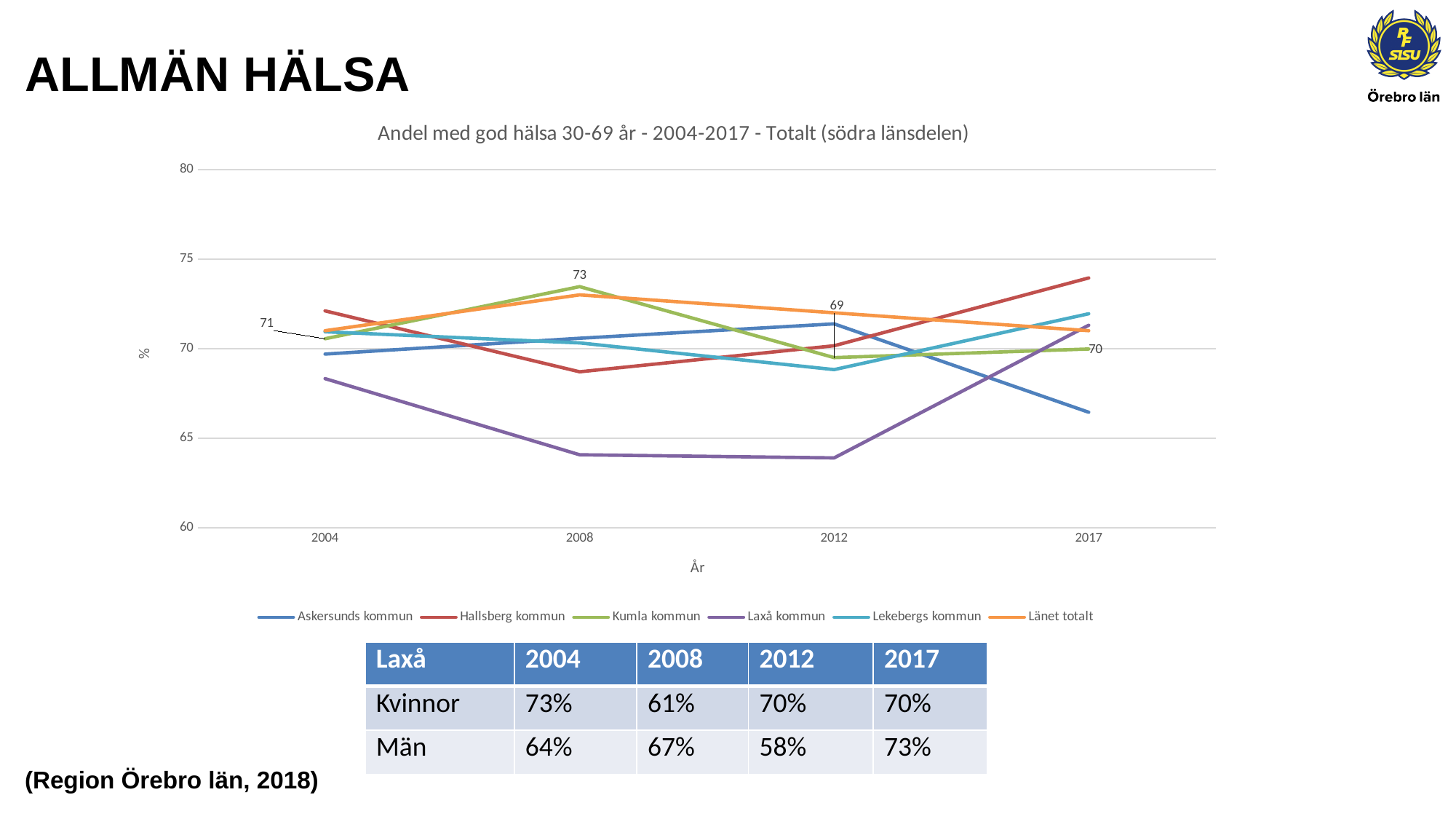
How many years are plotted along the x axis of the chart? 4 Does the Laxå kommun line rise or fall between 2012 and 2017? rise What is the title of the chart? Andel med god hälsa 30-69 år - 2004-2017 - Totalt (södra länsdelen) Which series has the highest value in 2017? Hallsberg kommun What is the label on the x axis of the chart? År Is the value for Laxå kommun in 2012 greater or less than 65? less How many series does the chart legend list? 6 Which series has the lowest value in 2012? Laxå kommun What is the labelled value for Kumla kommun in 2017? 70 Is the value for Askersunds kommun in 2017 greater or less than 70? less What is the labelled value for Kumla kommun in 2012? 69 What kind of chart is shown on the slide? line chart